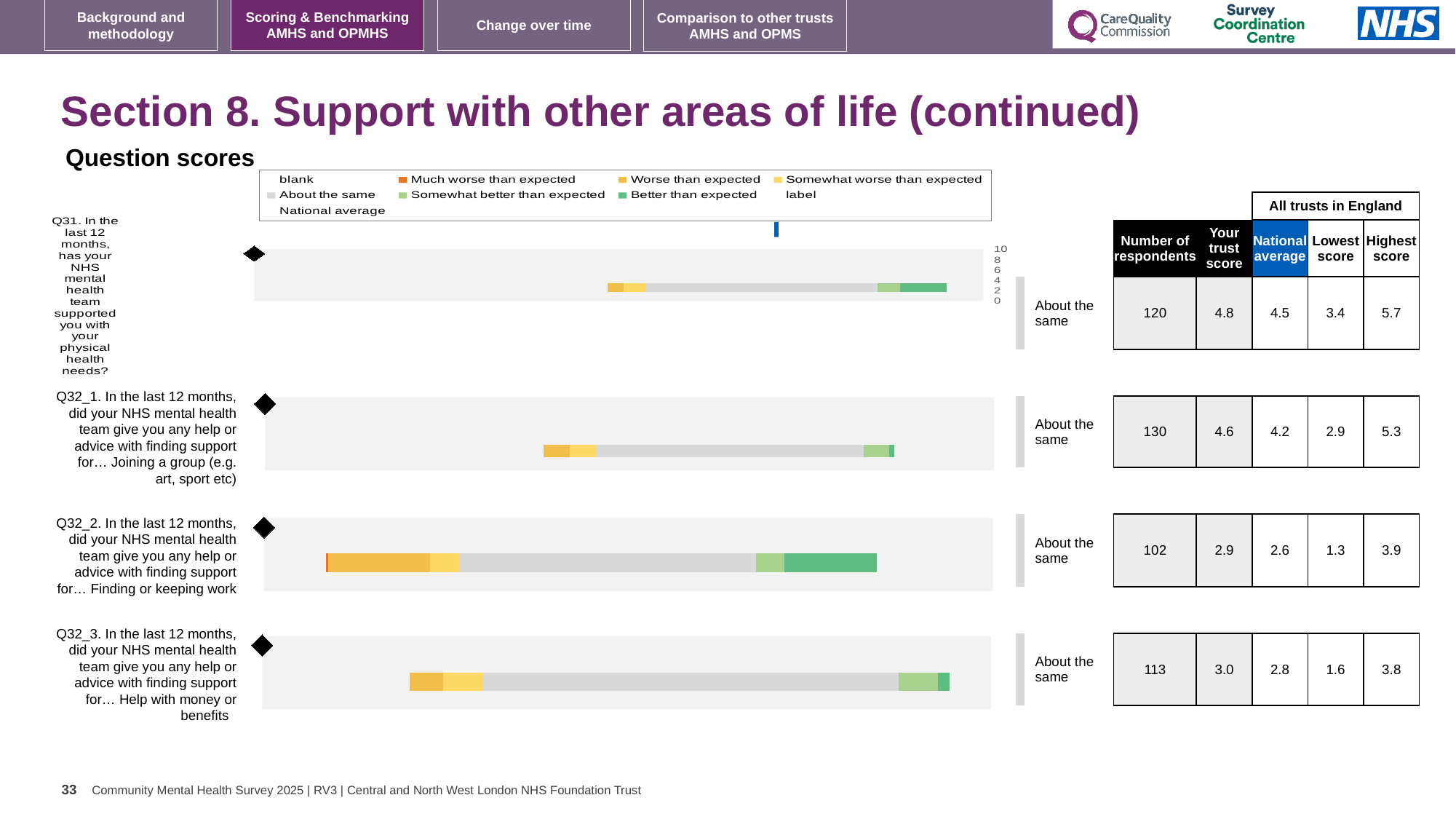
What is the difference between the highest score and the lowest score for Q32_3? 2.2 For Q32_1, which is larger: the trust score or the national average? the trust score Which question has the lowest 'Your trust score'? Q32_2 What is the highest score among all trusts in England for Q32_1 (joining a group)? 5.3 What is the national average for Q32_2 (finding or keeping work)? 2.6 Which question has the highest 'Your trust score'? Q31 What kind of chart is used to show the question scores on this slide? bar chart Which legend entry is shown in orange? Much worse than expected How many questions (bars) are shown in the question scores chart? 4 What is the difference between the trust score and the national average for Q31? 0.3 How many respondents are shown for Q32_3 (help with money or benefits)? 113 What is the 'Your trust score' value for Q31 (support with physical health needs)? 4.8